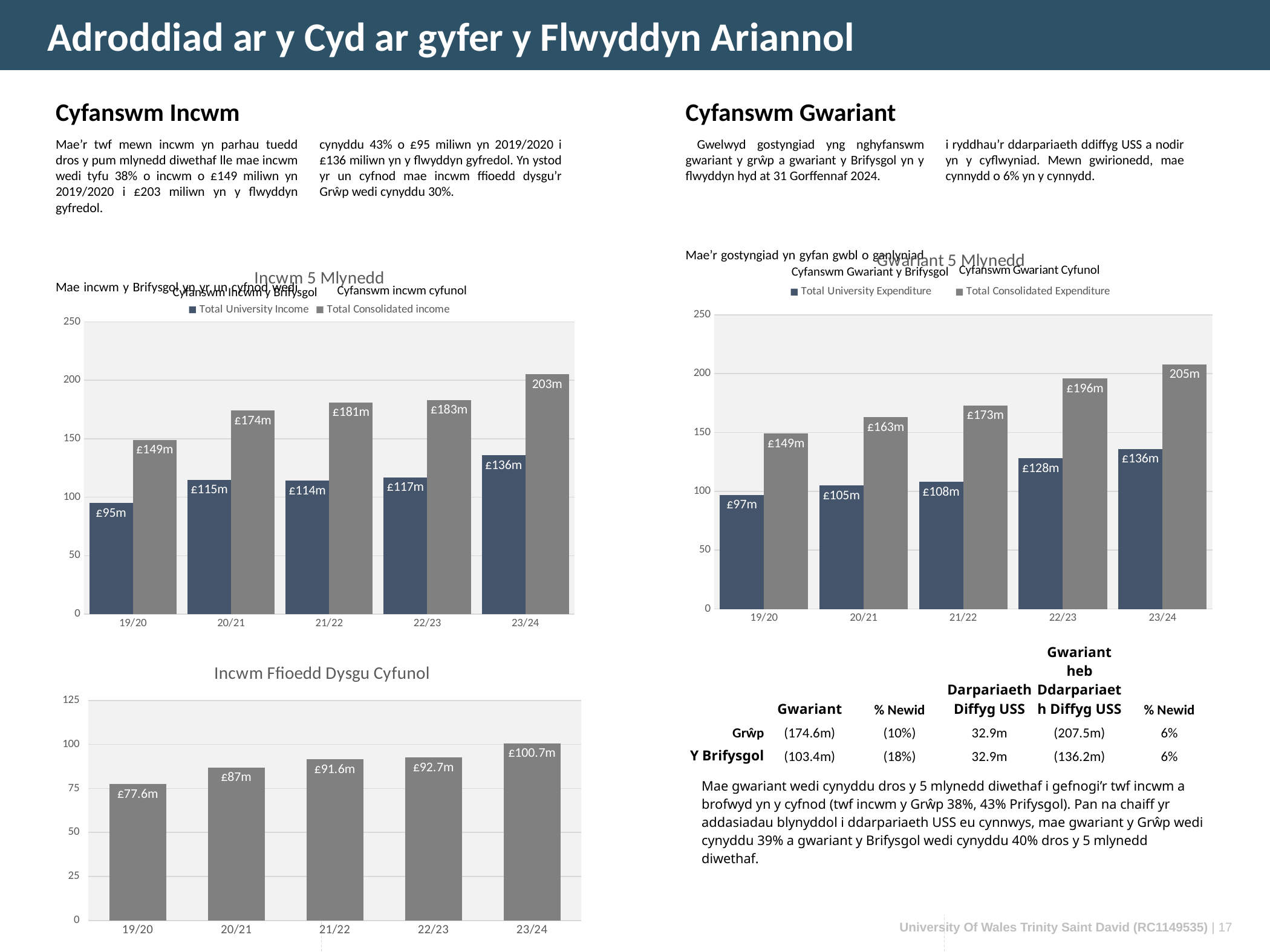
In the 'Incwm Ffioedd Dysgu Cyfunol' chart, do the values rise or fall from 19/20 to 23/24? rise In the 'Gwariant 5 Mlynedd' chart, which year has the highest Total Consolidated Expenditure? 23/24 In the 'Gwariant 5 Mlynedd' chart, is Total Consolidated Expenditure for 20/21 greater or less than 150? greater In the 'Incwm 5 Mlynedd' chart, what is the difference between Total Consolidated income and Total University Income in 22/23? £66m What kind of chart is 'Incwm Ffioedd Dysgu Cyfunol'? bar chart In the 'Incwm Ffioedd Dysgu Cyfunol' chart, how many years are shown on the x axis? 5 In the 'Incwm Ffioedd Dysgu Cyfunol' chart, what is the value for 21/22? £91.6m In the 'Incwm 5 Mlynedd' chart, what is the Total University Income for 19/20? £95m In the 'Incwm 5 Mlynedd' chart, what is the Total Consolidated income for 23/24? 203m In the 'Gwariant 5 Mlynedd' chart, how many series does the legend list? 2 In the 'Gwariant 5 Mlynedd' chart, what is the Total University Expenditure for 21/22? £108m In the 'Incwm 5 Mlynedd' chart, which year has the lowest Total University Income? 19/20